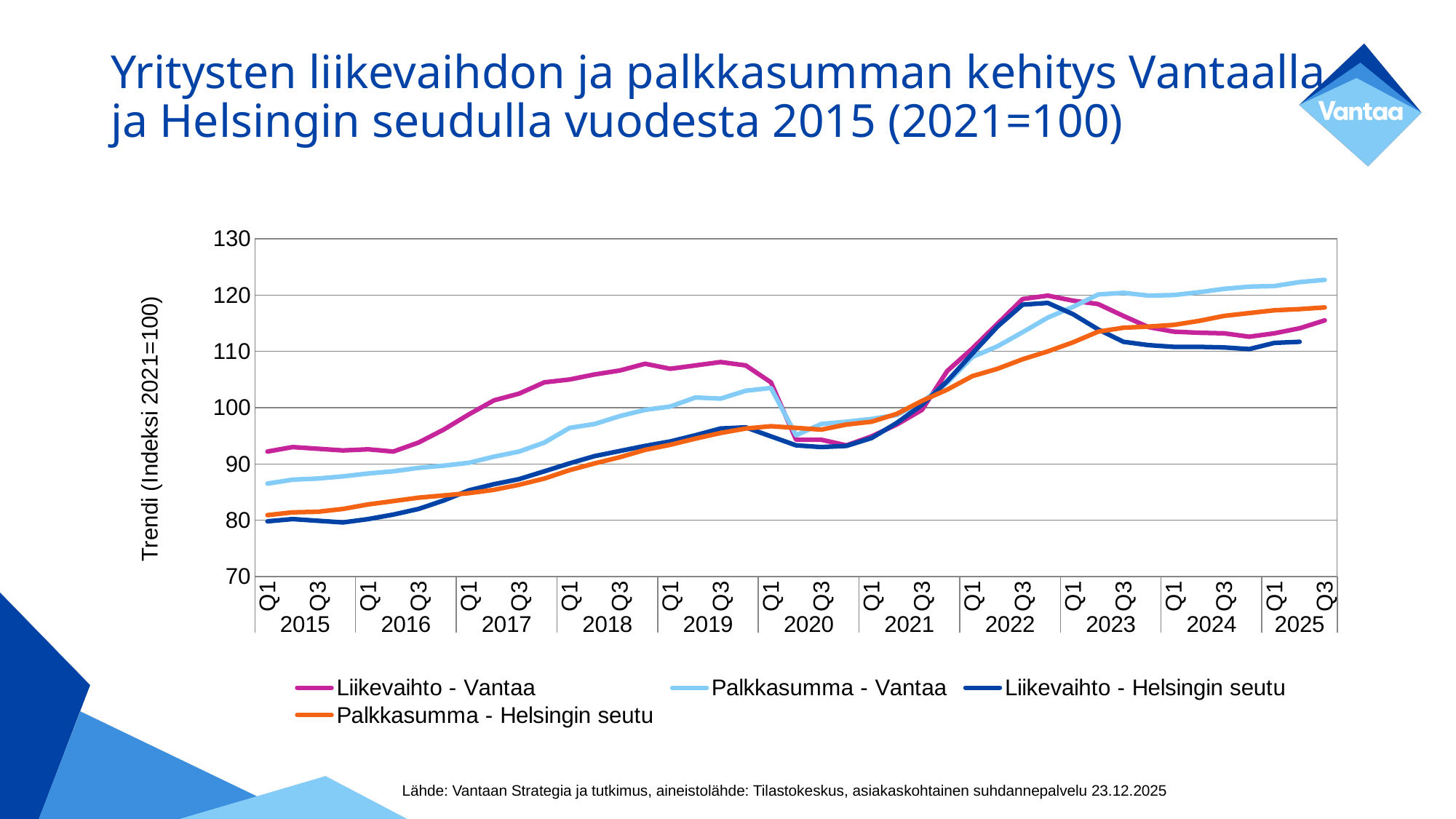
Does the Palkkasumma - Vantaa series generally rise or fall from 2015 to 2025? rise Is the value for Palkkasumma - Vantaa in Q1 2020 greater or less than 100? greater In Q1 2015, which is larger: Liikevaihto - Vantaa or Liikevaihto - Helsingin seutu? Liikevaihto - Vantaa Is the value for Palkkasumma - Vantaa in Q3 2025 greater or less than 120? greater Is the value for Palkkasumma - Helsingin seutu in Q1 2015 greater or less than 90? less Which series has the highest value in Q3 2025? Palkkasumma - Vantaa What kind of chart is shown on the slide? line chart How many series does the legend list? 4 Which series is drawn in the magenta (pink) line? Liikevaihto - Vantaa What is the label of the vertical axis? Trendi (Indeksi 2021=100) How many years are labelled along the x axis? 11